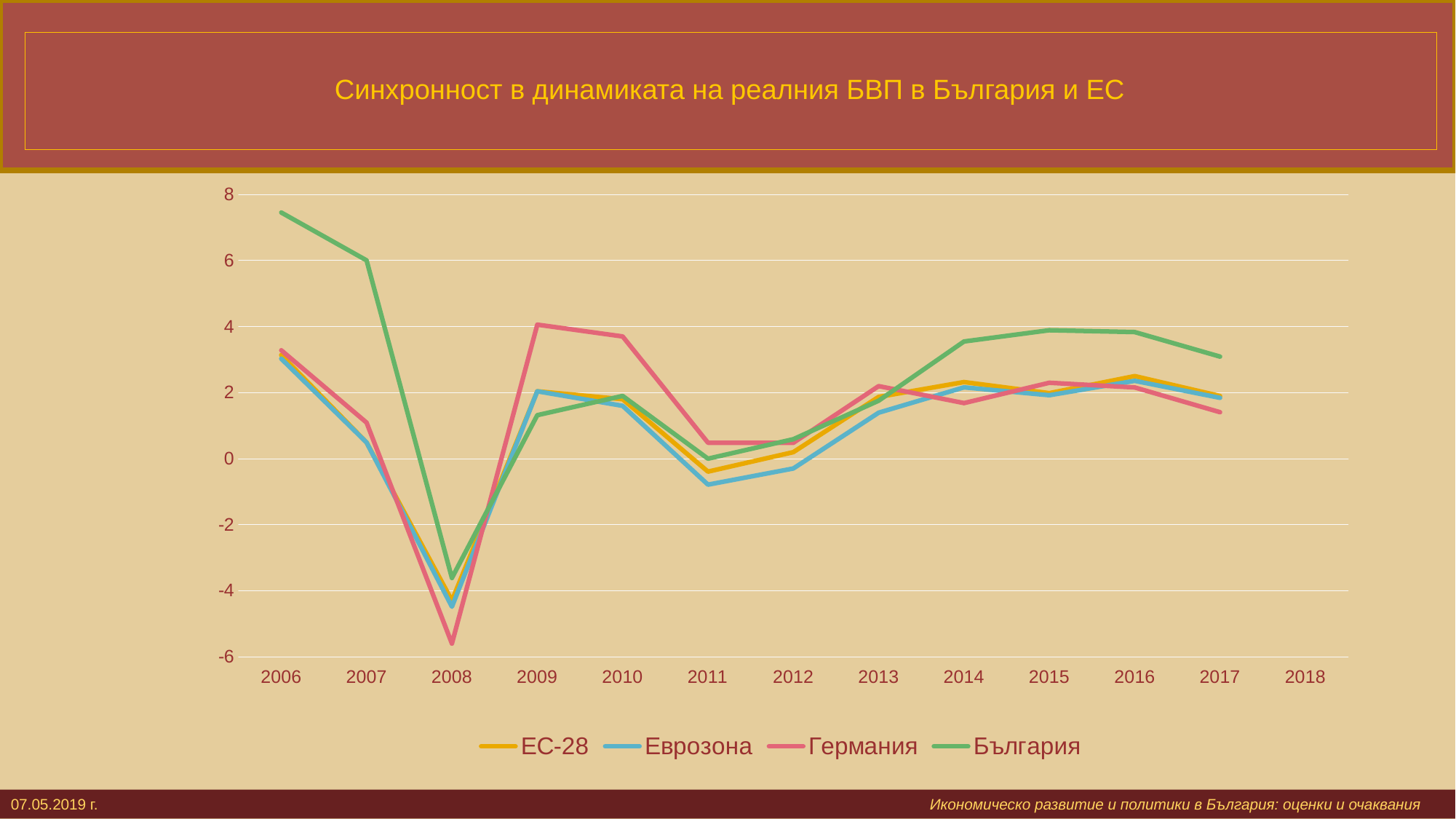
Is the value for България in 2006 greater or less than 6? greater Which is larger in 2017, the value for България or the value for Германия? България Which series has the lowest value in 2008? Германия Which series has the highest value in 2006? България Is the value for Германия in 2008 greater or less than -4? less What colour is the line for България in the legend? green How many series does the legend list? 4 Is the value for Еврозона in 2011 greater or less than 0? less How many year labels are shown on the x axis? 13 What kind of chart is shown on the slide? line chart Which series has the highest value in 2009? Германия Does the value for България rise or fall from 2006 to 2008? fall